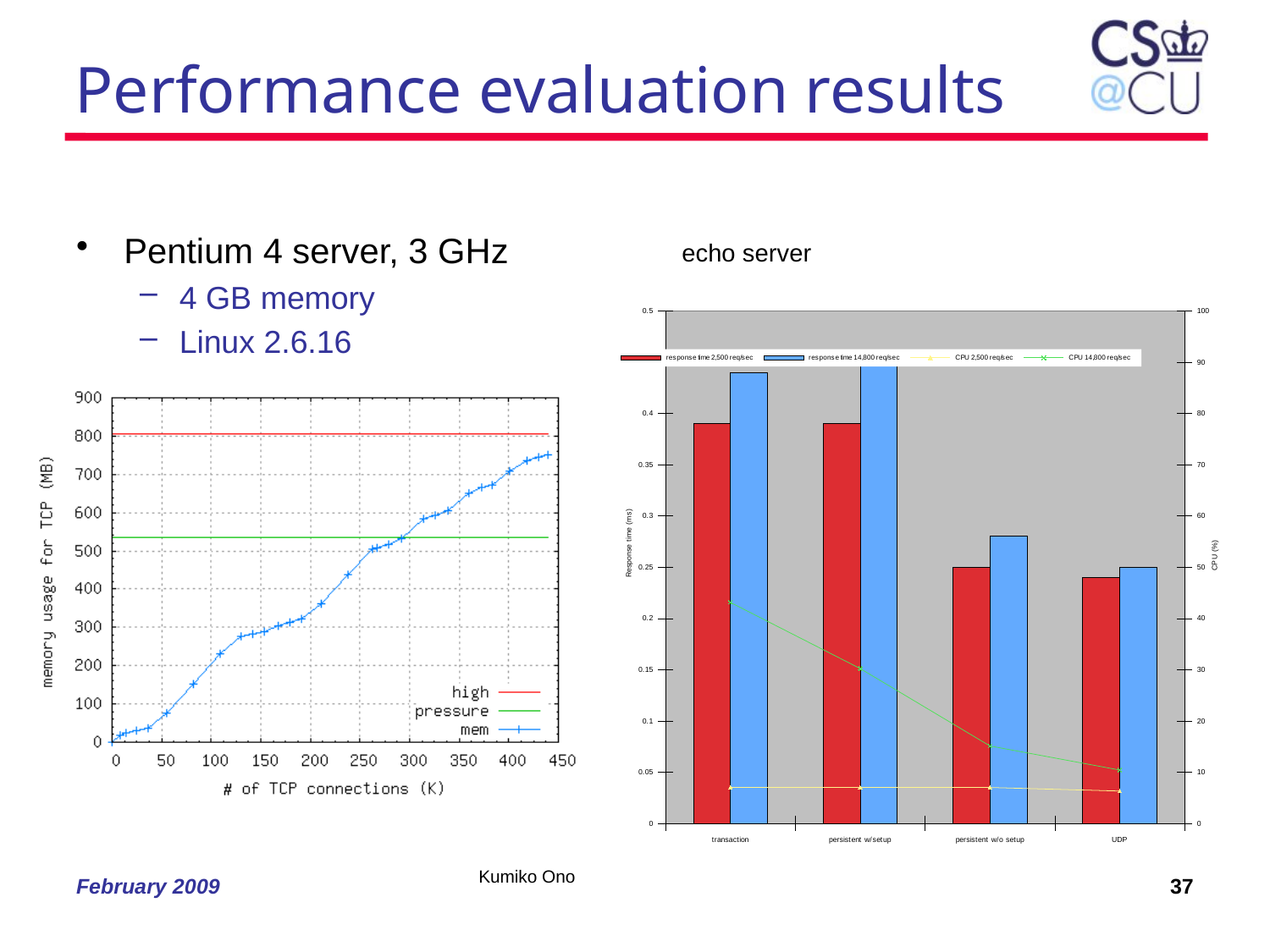
In the echo server chart on the right, which is larger: the response time at 14,800 req/sec for transaction or for persistent w/setup? persistent w/setup In the echo server chart on the right, does the CPU 14,800 req/sec line rise or fall from transaction to UDP? falls What kind of chart is the left chart showing memory usage for TCP? line chart In the echo server chart on the right, which category has the highest response time at 14,800 req/sec? persistent w/setup In the echo server chart on the right, how many series does the legend list? 4 In the echo server chart on the right, is the response time at 2,500 req/sec for transaction greater or less than 0.35 ms? greater In the left chart (memory usage for TCP), is the mem value at 200K TCP connections greater or less than 300 MB? greater In the left chart (memory usage for TCP), is the pressure line greater or less than 600 MB? less In the left chart (memory usage for TCP), how many series does the legend list? 3 In the left chart (memory usage for TCP), does the mem line rise or fall as the number of TCP connections increases? rises In the echo server chart on the right, how many categories are shown on the x axis? 4